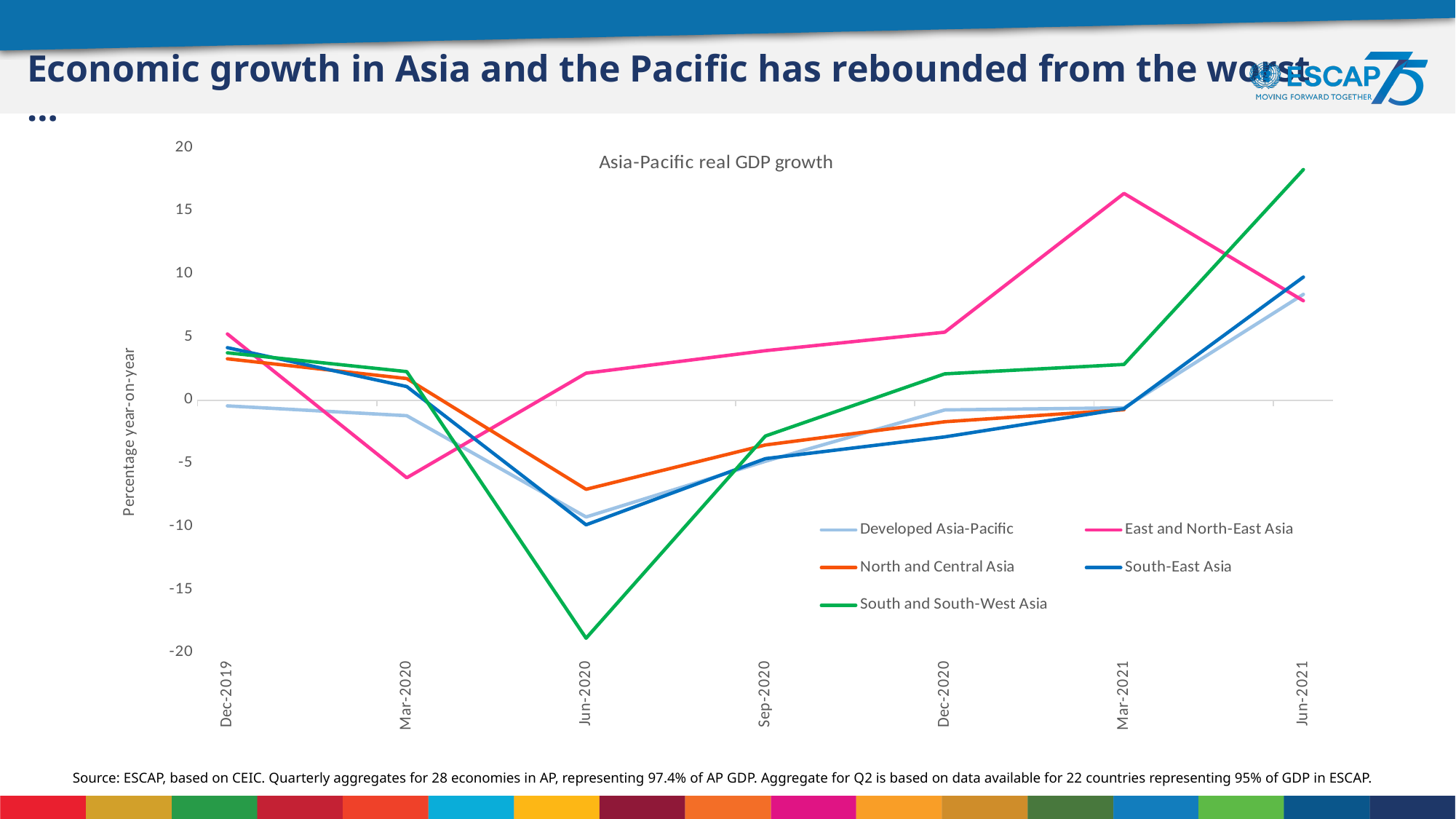
Which series has the lowest value in Jun-2020? South and South-West Asia How many series does the legend list? 5 Which series has the highest value in Jun-2020? East and North-East Asia What is the title of the chart? Asia-Pacific real GDP growth Is the value for South and South-West Asia in Jun-2020 greater or less than -15? less Is the value for South and South-West Asia in Jun-2021 greater or less than 15? greater Which series has the highest value in Jun-2021? South and South-West Asia Which series has the lowest value in Mar-2020? East and North-East Asia Which series has the highest value in Mar-2021? East and North-East Asia How many time points are shown along the x axis? 7 What kind of chart is shown on the slide? line chart What is the label on the vertical axis? Percentage year-on-year